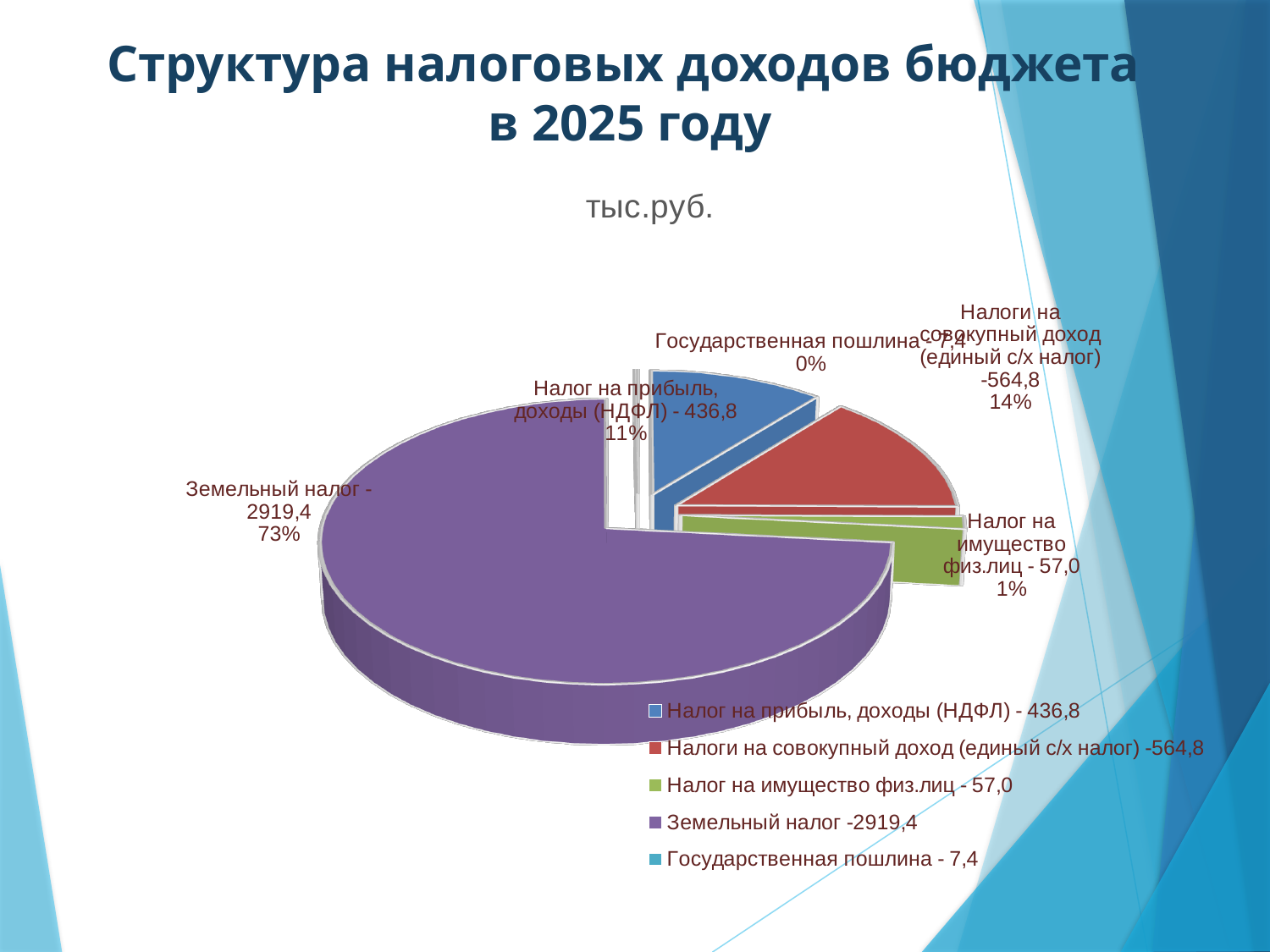
What value is shown for Государственная пошлина? 7,4 How many slices does the pie chart have? 5 What kind of chart is shown on the slide? pie chart What unit is given in the chart title? тыс.руб. What share of the pie does Налог на прибыль, доходы (НДФЛ) represent? 11% Which category has the smallest slice of the pie? Государственная пошлина What share of the pie does Налог на имущество физ.лиц represent? 1% Which is larger: Налоги на совокупный доход (единый с/х налог) or Налог на прибыль, доходы (НДФЛ)? Налоги на совокупный доход (единый с/х налог) Which category has the largest slice of the pie? Земельный налог How many entries does the legend list? 5 What share of the pie does Земельный налог represent? 73%